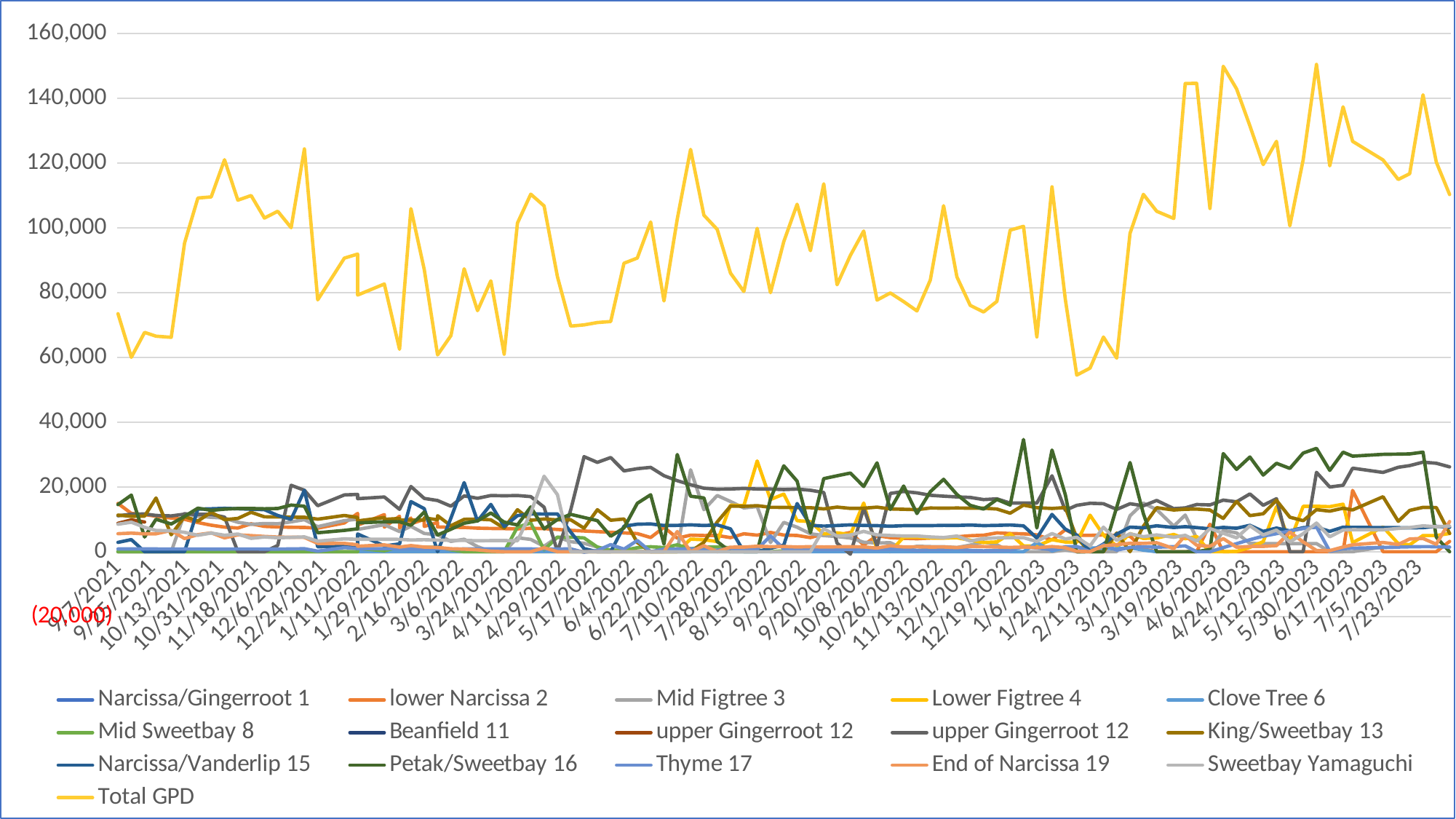
What is the highest value shown on the vertical axis? 160,000 Is the highest value reached by Total GPD greater or less than 140,000? greater Is the last plotted value of Total GPD greater or less than 100,000? greater What kind of chart is shown on the slide? line chart Is the lowest value reached by Total GPD greater or less than 60,000? less Which legend entry appears twice in the legend? upper Gingerroot 12 Which series has the highest values throughout the chart? Total GPD Does Total GPD rise or fall overall from the start of the series to the end? rises How many series does the legend list? 16